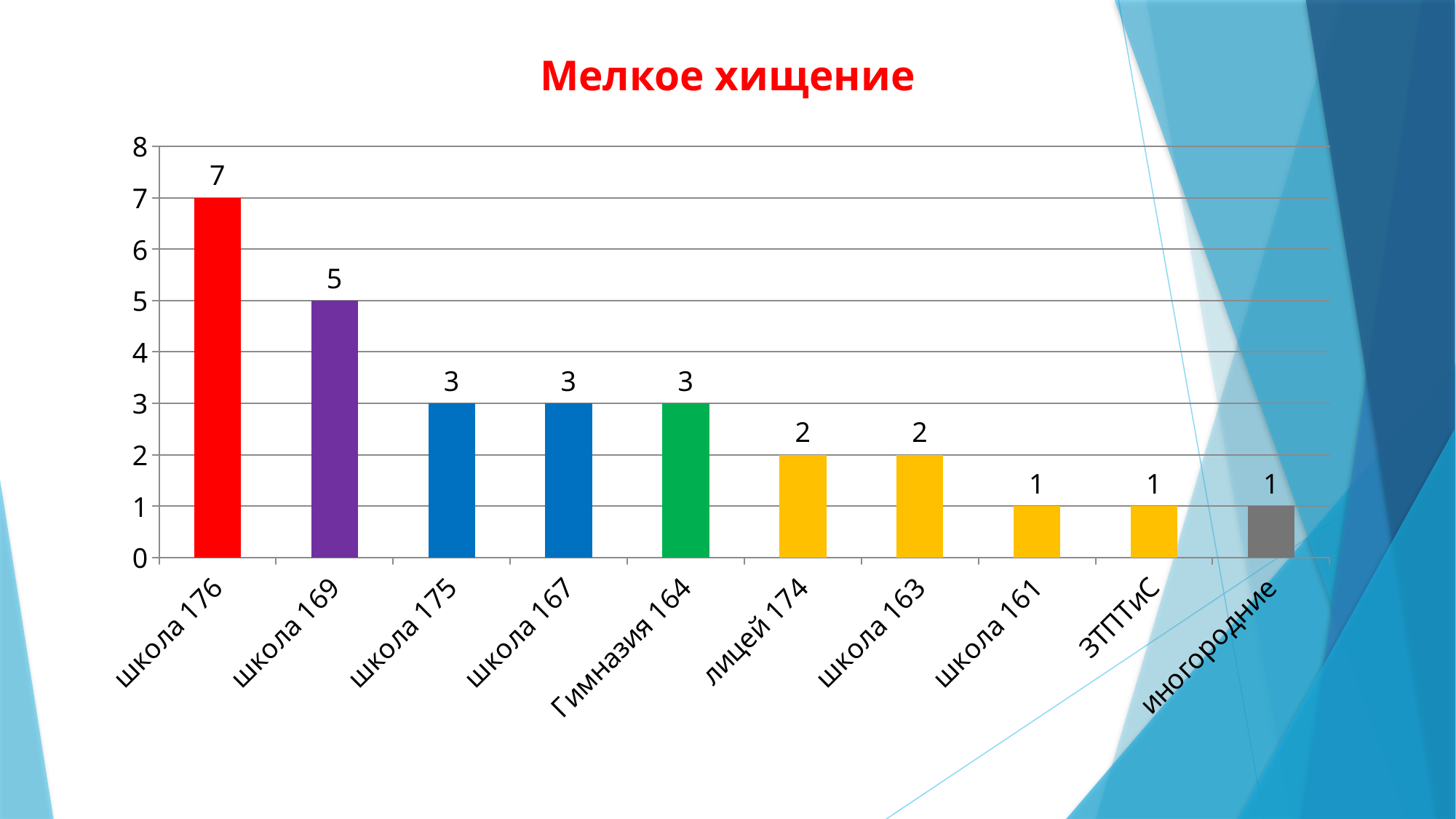
What is the value for Гимназия 164? 3 How many categories are shown on the x axis? 10 Which is larger, the value for школа 175 or the value for школа 161? школа 175 What is the value for иногородние? 1 What kind of chart is shown on the slide? bar chart What is the title of the chart? Мелкое хищение What is the value for школа 169? 5 Which category has the highest value? школа 176 What is the difference between the values for школа 169 and школа 163? 3 What is the value for лицей 174? 2 What is the value for школа 176? 7 What is the difference between the values for школа 176 and школа 169? 2